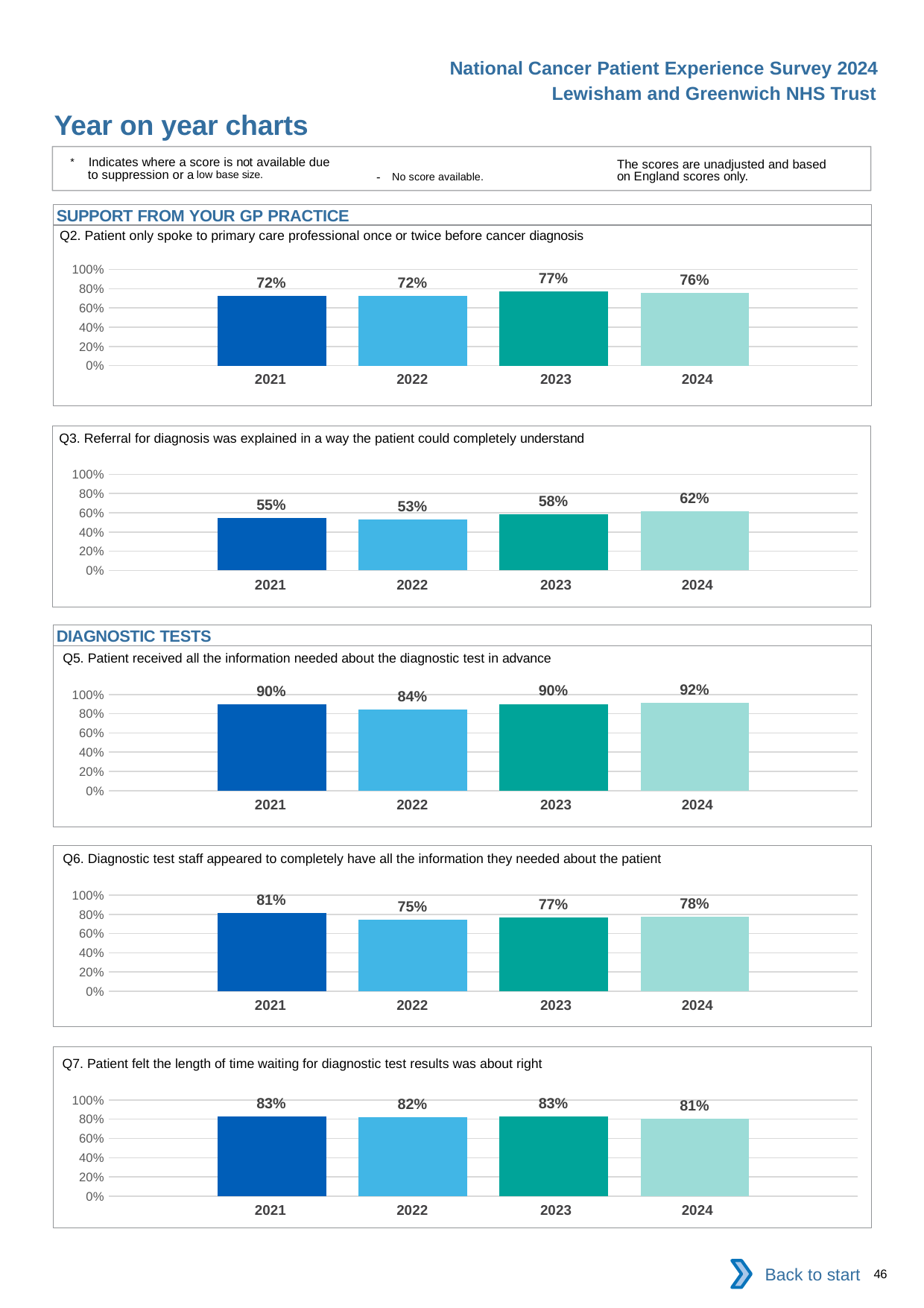
In the Q2 chart (patient only spoke to primary care professional once or twice before cancer diagnosis), what is the value for 2023? 77% Which section heading appears above the Q5 chart? DIAGNOSTIC TESTS In the Q6 chart (diagnostic test staff appeared to completely have all the information they needed about the patient), which is larger, the value for 2021 or the value for 2022? 2021 In the Q3 chart (referral for diagnosis was explained in a way the patient could completely understand), which year has the highest value? 2024 In the Q3 chart (referral for diagnosis was explained in a way the patient could completely understand), which year has the lowest value? 2022 In the Q3 chart (referral for diagnosis was explained in a way the patient could completely understand), do the values rise or fall from 2022 to 2024? Rise In the Q7 chart (patient felt the length of time waiting for diagnostic test results was about right), what is the value for 2024? 81% In the Q6 chart (diagnostic test staff appeared to completely have all the information they needed about the patient), what is the difference between the 2021 and 2022 values? 6% In the Q7 chart (patient felt the length of time waiting for diagnostic test results was about right), is the value for 2022 greater or less than 80%? greater What kind of chart is the Q5 chart (patient received all the information needed about the diagnostic test in advance)? Bar chart In the Q5 chart (patient received all the information needed about the diagnostic test in advance), what is the difference between the 2024 and 2022 values? 8% How many years are plotted in the Q2 chart (patient only spoke to primary care professional once or twice before cancer diagnosis)? 4